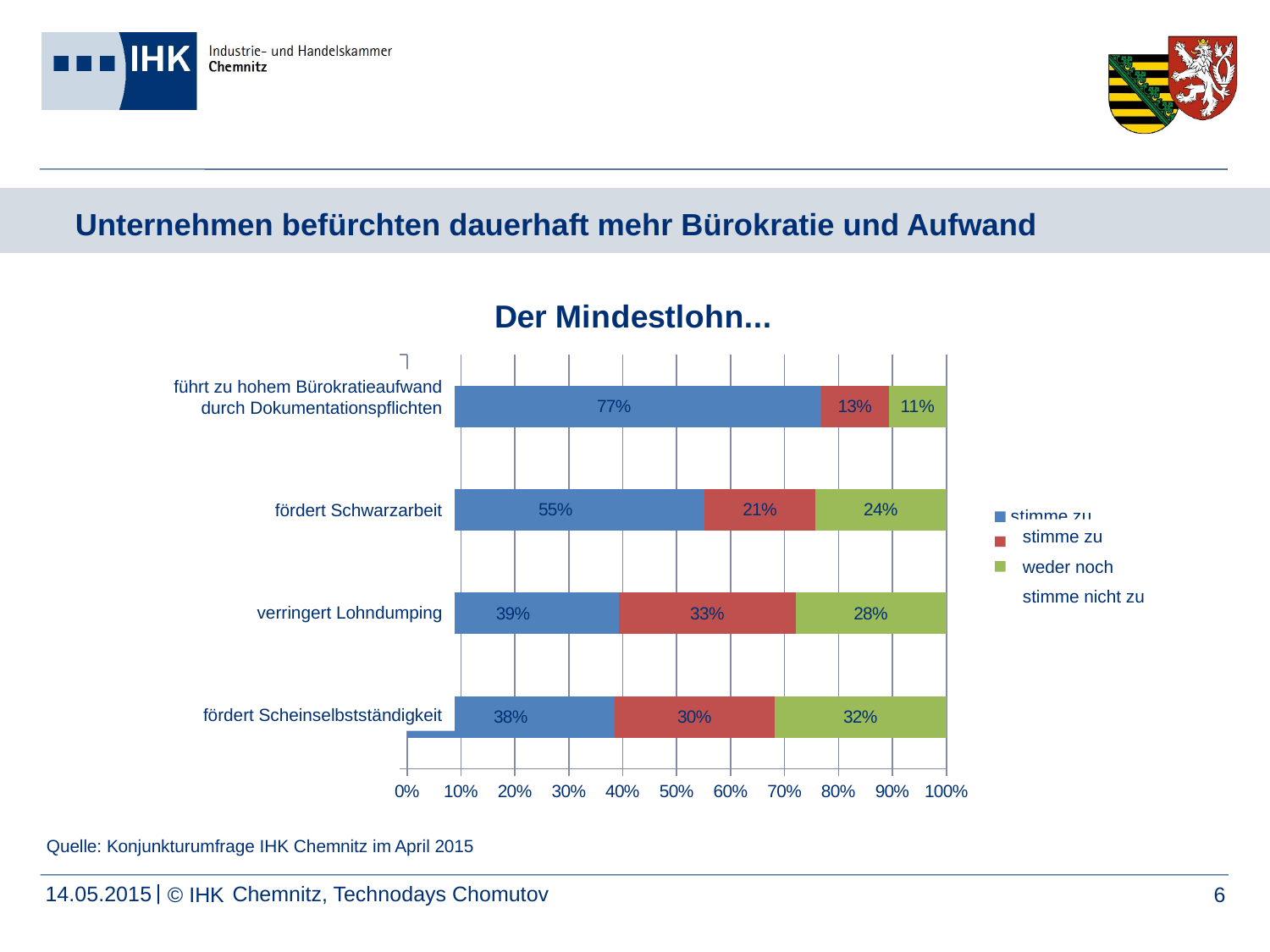
What kind of chart is shown on the slide? Stacked bar chart Which statement has the highest "stimme zu" share? führt zu hohem Bürokratieaufwand durch Dokumentationspflichten What is the total of the stacked bar for "fördert Schwarzarbeit"? 100% What is the "weder noch" value for "fördert Scheinselbstständigkeit"? 30% Which statement has the lowest "stimme zu" share? fördert Scheinselbstständigkeit What is the "weder noch" value for "verringert Lohndumping"? 33% What percentage of respondents answered "stimme zu" for "fördert Schwarzarbeit"? 55% How many statements about the Mindestlohn are shown in the chart? 4 What is the title of the chart? Der Mindestlohn... Which has the larger "stimme nicht zu" share: "fördert Scheinselbstständigkeit" or "verringert Lohndumping"? fördert Scheinselbstständigkeit What is the "stimme nicht zu" share for "führt zu hohem Bürokratieaufwand durch Dokumentationspflichten"? 11% How many percentage points higher is the "stimme zu" share for "führt zu hohem Bürokratieaufwand durch Dokumentationspflichten" than for "fördert Schwarzarbeit"? 22 percentage points